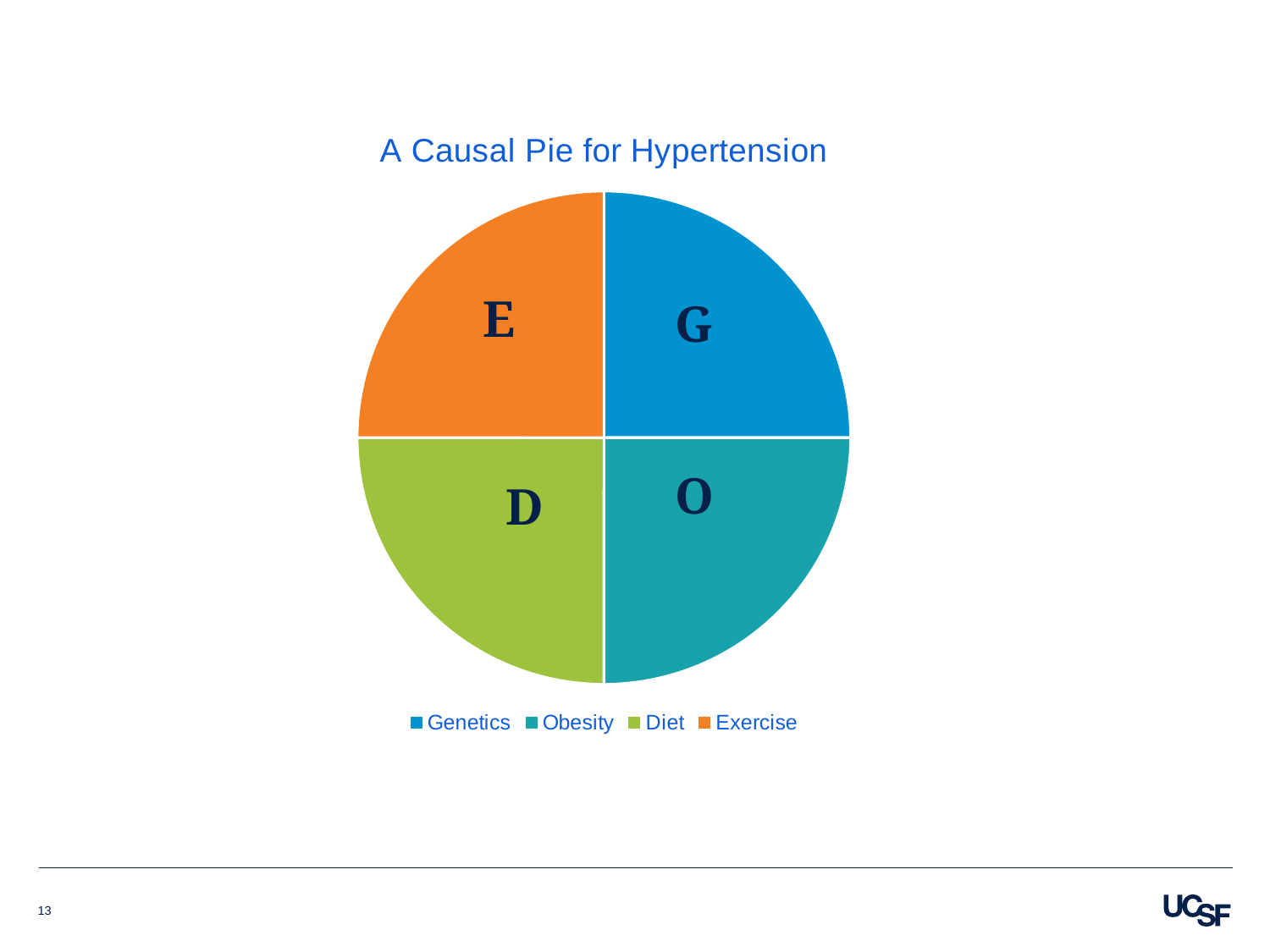
Which legend category does the slice labelled "G" represent? Genetics Which legend category does the slice labelled "O" represent? Obesity What kind of chart is shown on the slide? pie chart How many entries does the legend of the pie chart list? 4 What is the title of the pie chart? A Causal Pie for Hypertension How many slices does the pie chart have? 4 What colour is the Genetics slice in the pie chart? blue Which legend category does the slice labelled "E" represent? Exercise Which legend category does the slice labelled "D" represent? Diet